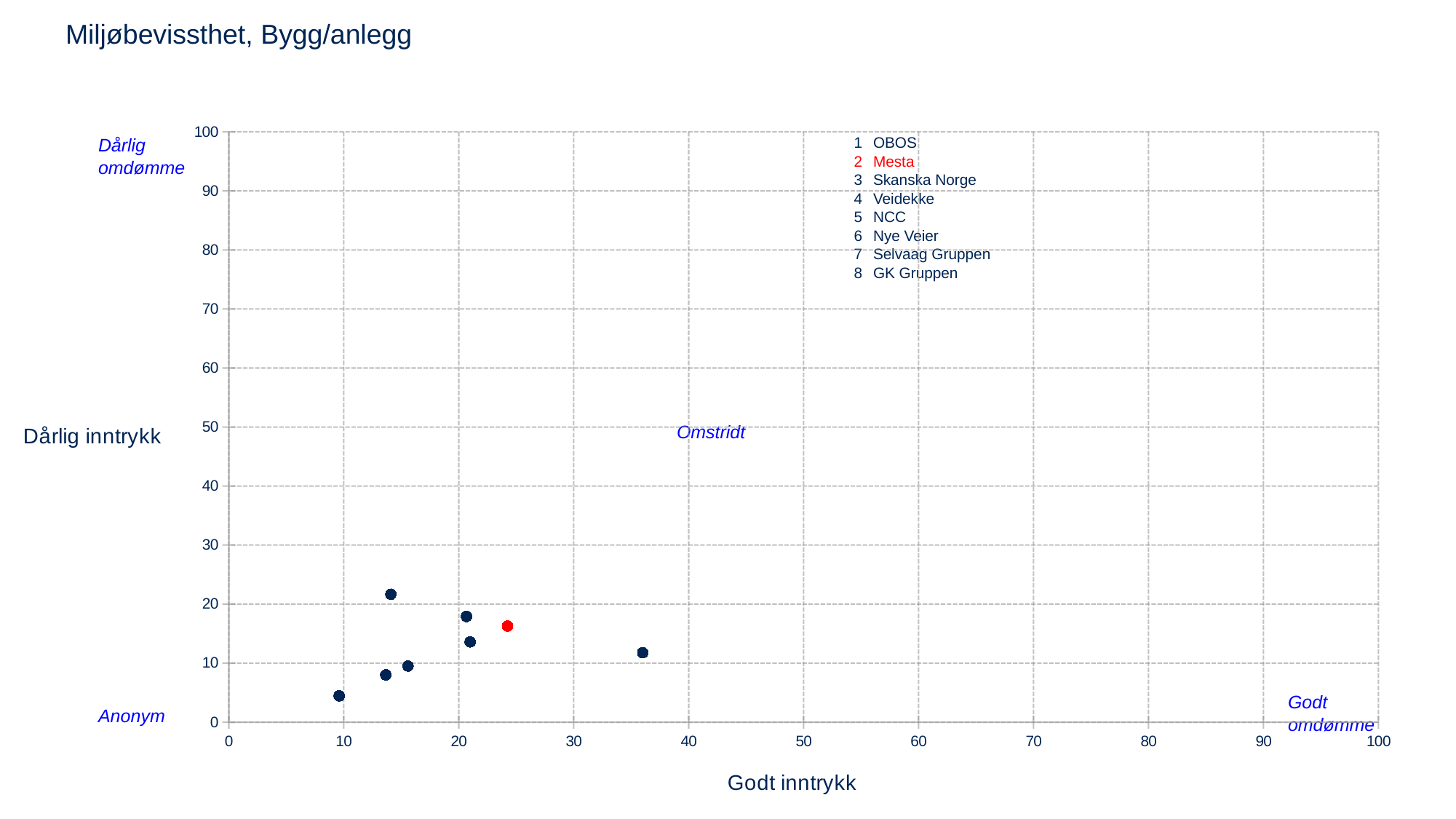
Is the Dårlig inntrykk (y-axis) value for Mesta greater or less than 20? less Is the Dårlig inntrykk (y-axis) value for Mesta greater or less than 10? greater How many companies are listed in the chart's legend? 8 What kind of chart is shown on the slide? scatter chart How many data points are plotted on the chart? 8 Is the Godt inntrykk (x-axis) value for Mesta greater or less than 30? less Which company is plotted as the red point? Mesta What is the title of the chart? Miljøbevissthet, Bygg/anlegg